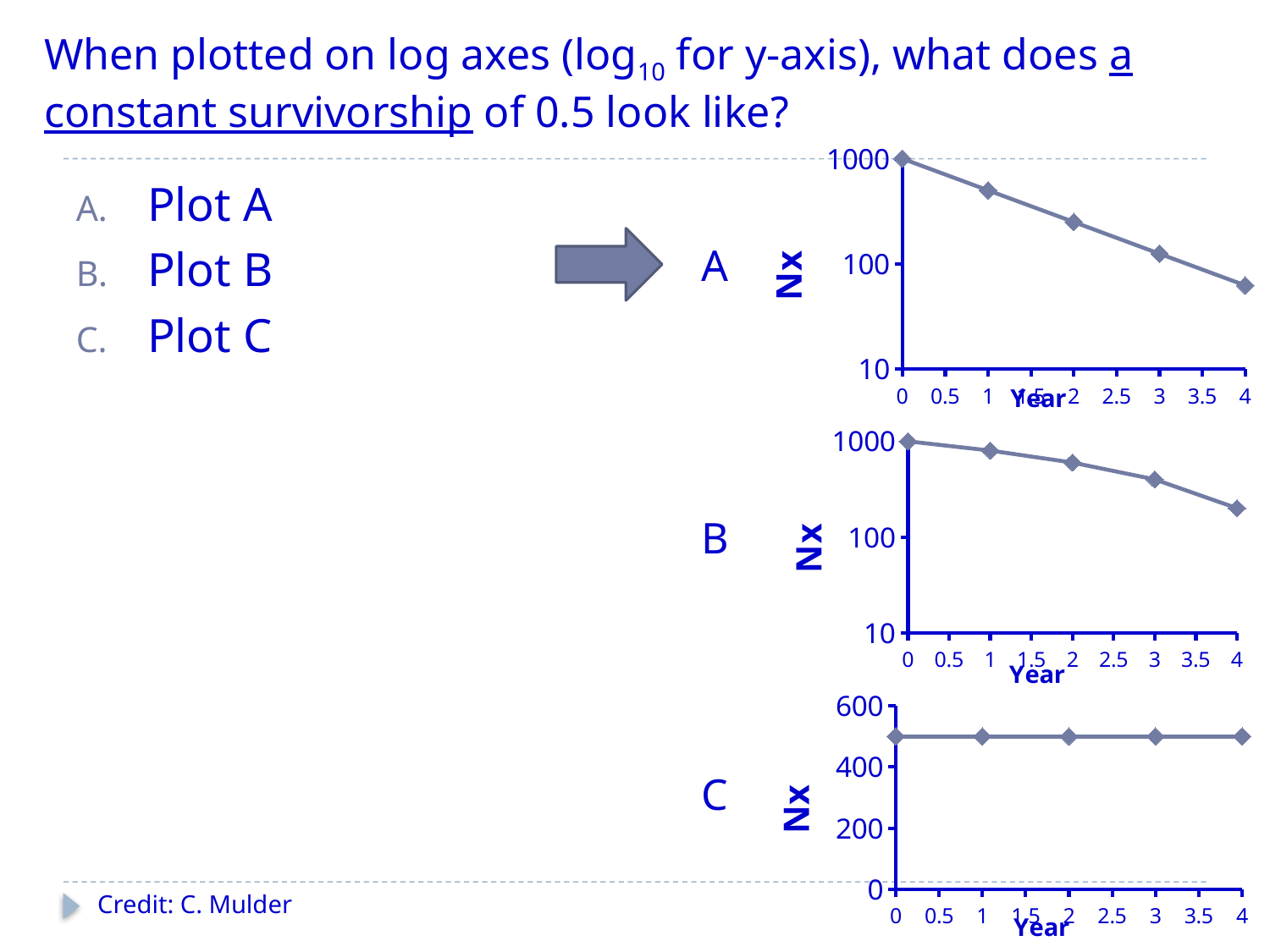
In Plot B, is the value at year 4 greater or less than 100? greater In Plot A, what is the value of Nx at year 0? 1000 In Plot B, at which year is Nx lowest? 4 In Plot A, do the values rise or fall as the year increases? fall At year 4, which plot has the larger Nx value, Plot A or Plot B? Plot B In Plot C, is the value at year 2 greater or less than 400? greater How many data points are plotted in Plot B? 5 In Plot A, is the value at year 4 greater or less than 100? less In Plot C, do the values rise, fall, or stay flat as the year increases? stay flat What is the label on the x-axis of Plot C? Year In Plot B, what is the value of Nx at year 0? 1000 What kind of chart is Plot A? line chart